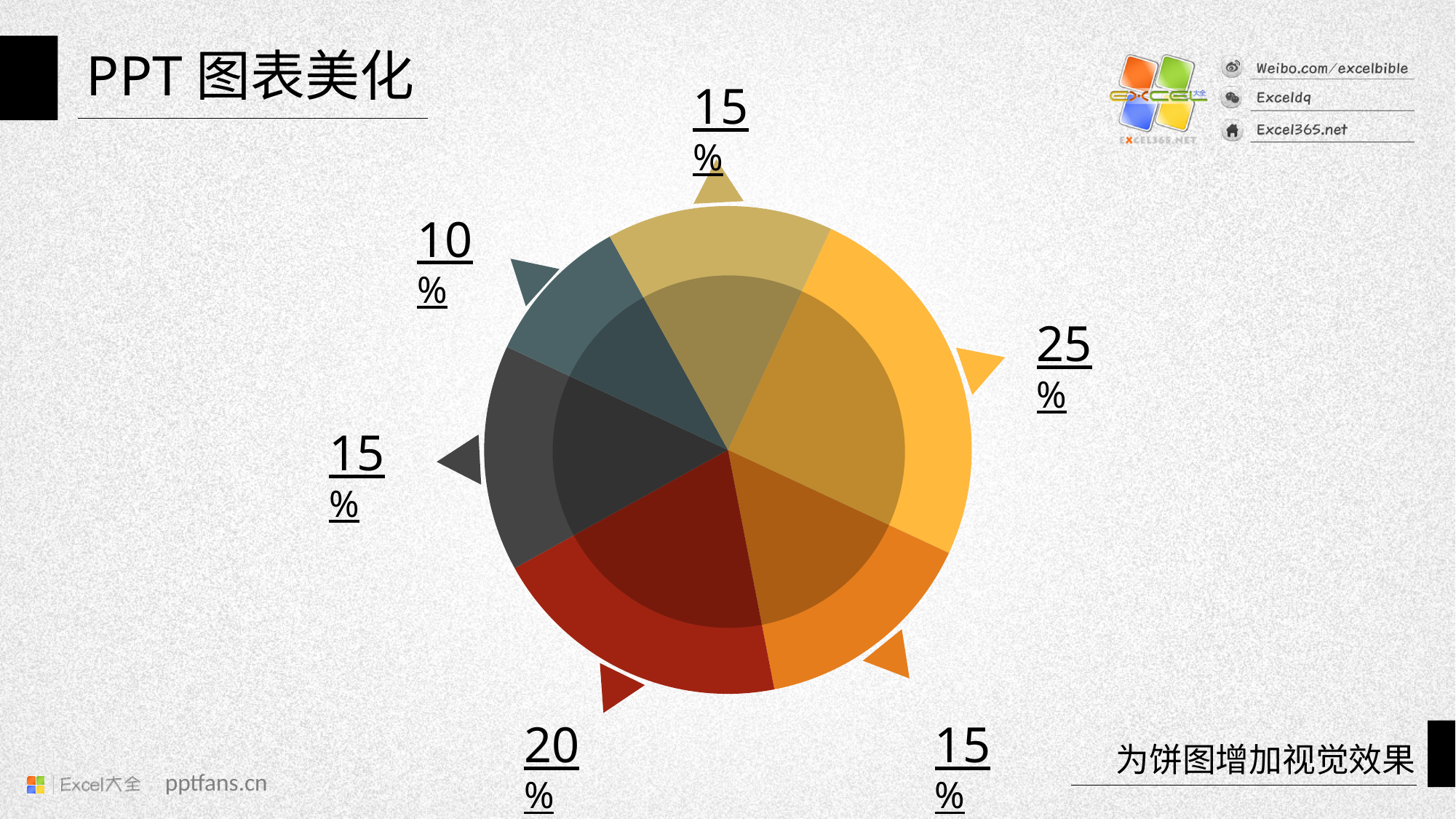
How many slices of the pie chart are labelled 15%? 3 What is the difference between the largest slice (25%) and the smallest slice (10%) of the pie chart? 15% What percentage is shown for the yellow-orange slice on the right side of the pie chart? 25% What is the value of the largest slice of the pie chart? 25% What percentage is shown for the dark teal slice at the upper left of the pie chart? 10% What kind of chart is shown on the slide? pie chart How many slices does the pie chart have? 6 What is the title text at the top left of the slide? PPT 图表美化 Which is larger in the pie chart: the red slice at the bottom or the dark teal slice at the upper left? the red slice at the bottom What percentage is shown for the red slice at the bottom of the pie chart? 20% What percentage is shown for the tan slice at the top of the pie chart? 15% What is the value of the smallest slice of the pie chart? 10%